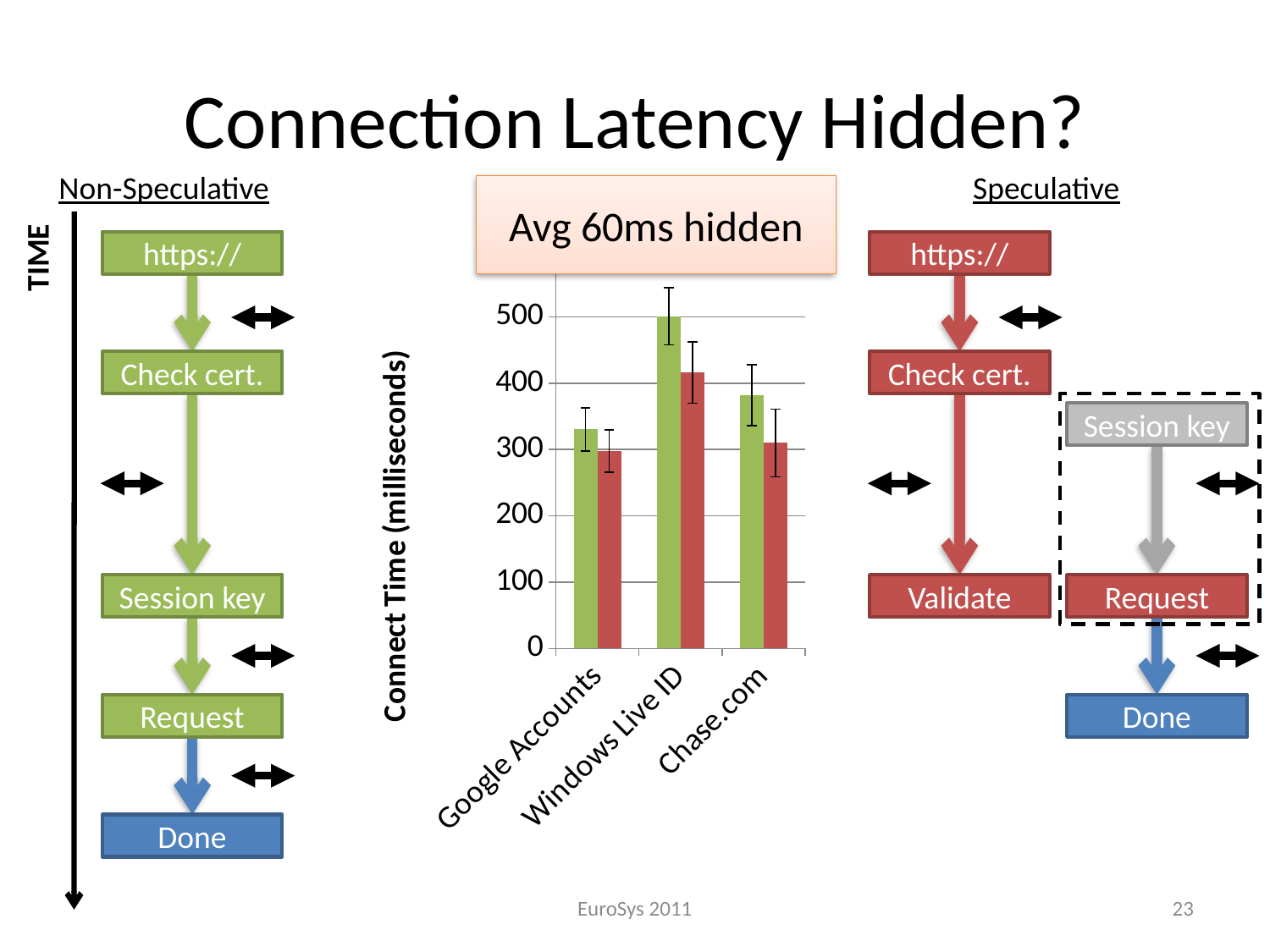
For Windows Live ID, which bar is taller, the green one or the red one? green Is the green bar for Google Accounts greater or less than 400? less Is the red bar for Chase.com greater or less than 400? less Which category has the tallest green bar in the bar chart? Windows Live ID Which category has the shortest green bar in the bar chart? Google Accounts How many categories are shown on the x axis of the bar chart? 3 What does the callout box above the bar chart say? Avg 60ms hidden Which category has the tallest red bar in the bar chart? Windows Live ID How many bars are plotted for each category in the bar chart? 2 What is the title of the y axis of the bar chart? Connect Time (milliseconds) Is the green bar for Windows Live ID greater or less than 400? greater What kind of chart is shown in the middle of the slide? bar chart